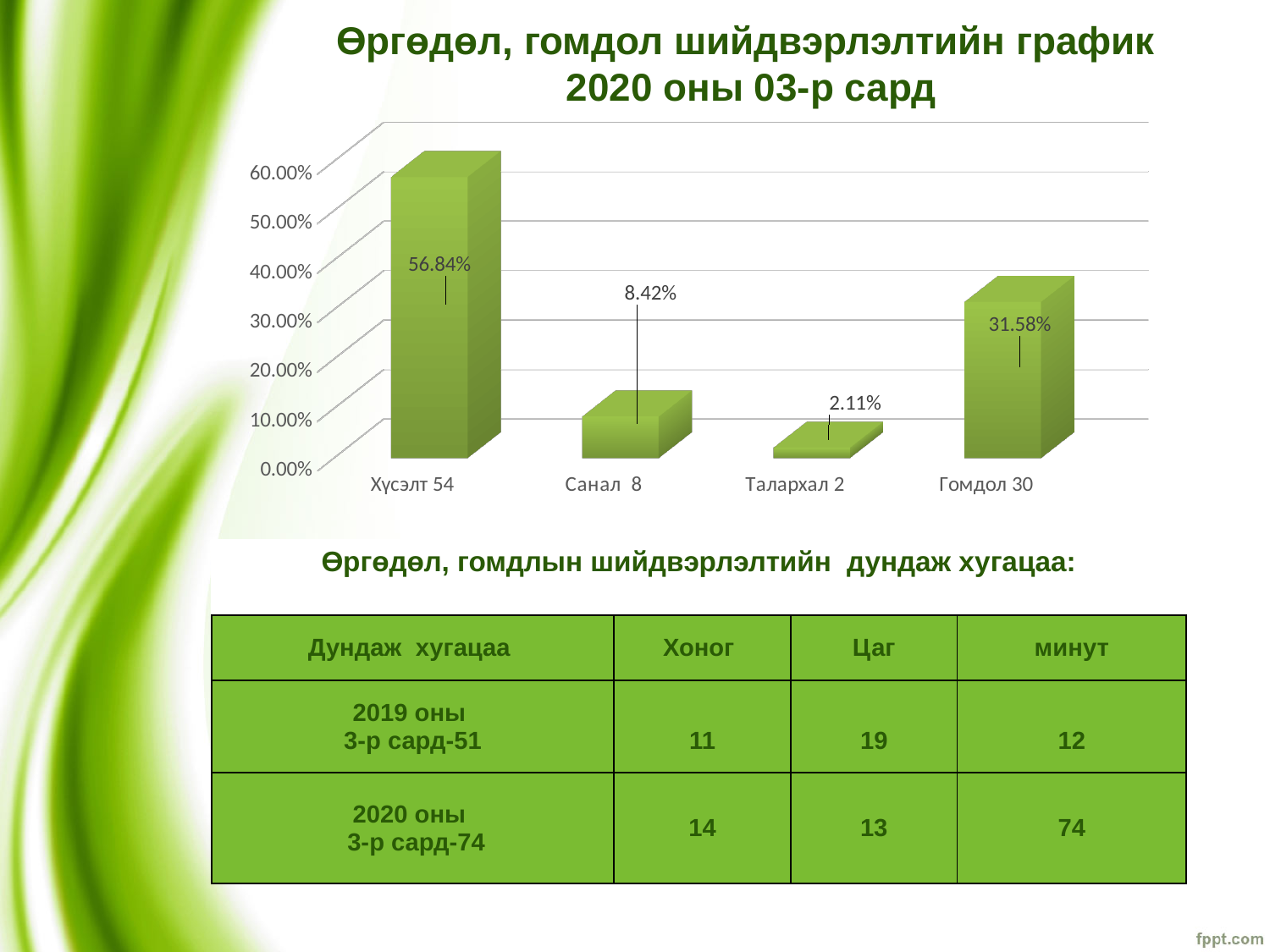
What kind of chart is shown on the slide? bar chart What is the value shown for Хүсэлт 54? 56.84% What is the difference between the values for Хүсэлт 54 and Гомдол 30? 25.26% Which category has the lowest value? Талархал 2 What is the value shown for Гомдол 30? 31.58% Which is larger, the value for Гомдол 30 or the value for Санал 8? Гомдол 30 What is the difference between the values for Санал 8 and Талархал 2? 6.31% How many categories are shown in the chart? 4 Which category has the highest value? Хүсэлт 54 What is the value shown for Санал 8? 8.42% Is the value for Гомдол 30 greater or less than 30.00%? greater What is the value shown for Талархал 2? 2.11%